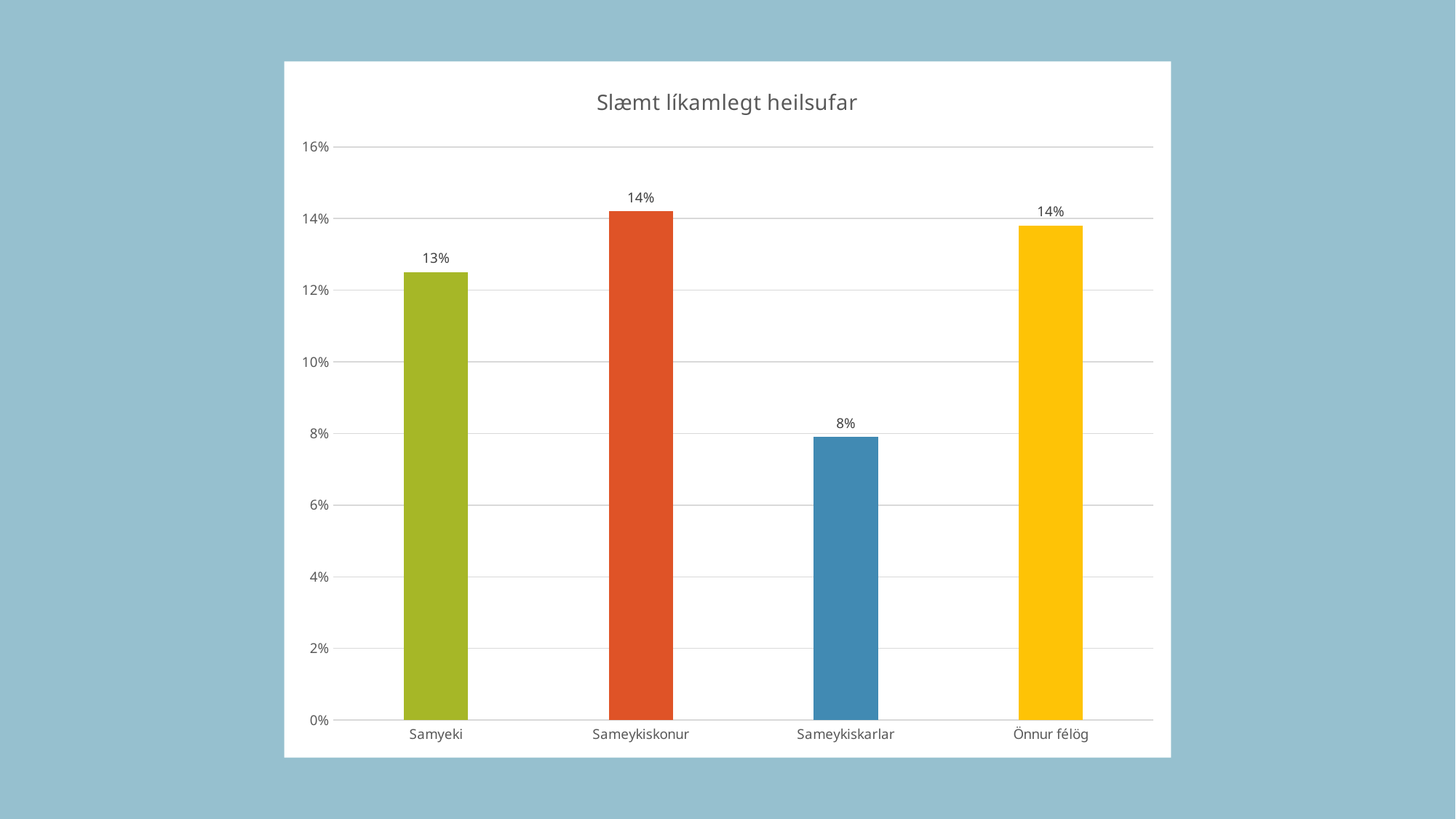
What is the value for Sameykiskarlar? 8% Which is larger, the value for Samyeki or the value for Sameykiskarlar? Samyeki What is the value for Samyeki? 13% What is the difference between the values for Samyeki and Sameykiskarlar? 5% What is the difference between the values for Sameykiskonur and Sameykiskarlar? 6% Is the value for Samyeki greater or less than 12%? greater How many categories are shown on the x axis? 4 What kind of chart is shown on the slide? Bar chart Is the value for Sameykiskarlar greater or less than 10%? less Which category has the lowest value? Sameykiskarlar What is the value for Önnur félög? 14% What is the value for Sameykiskonur? 14%